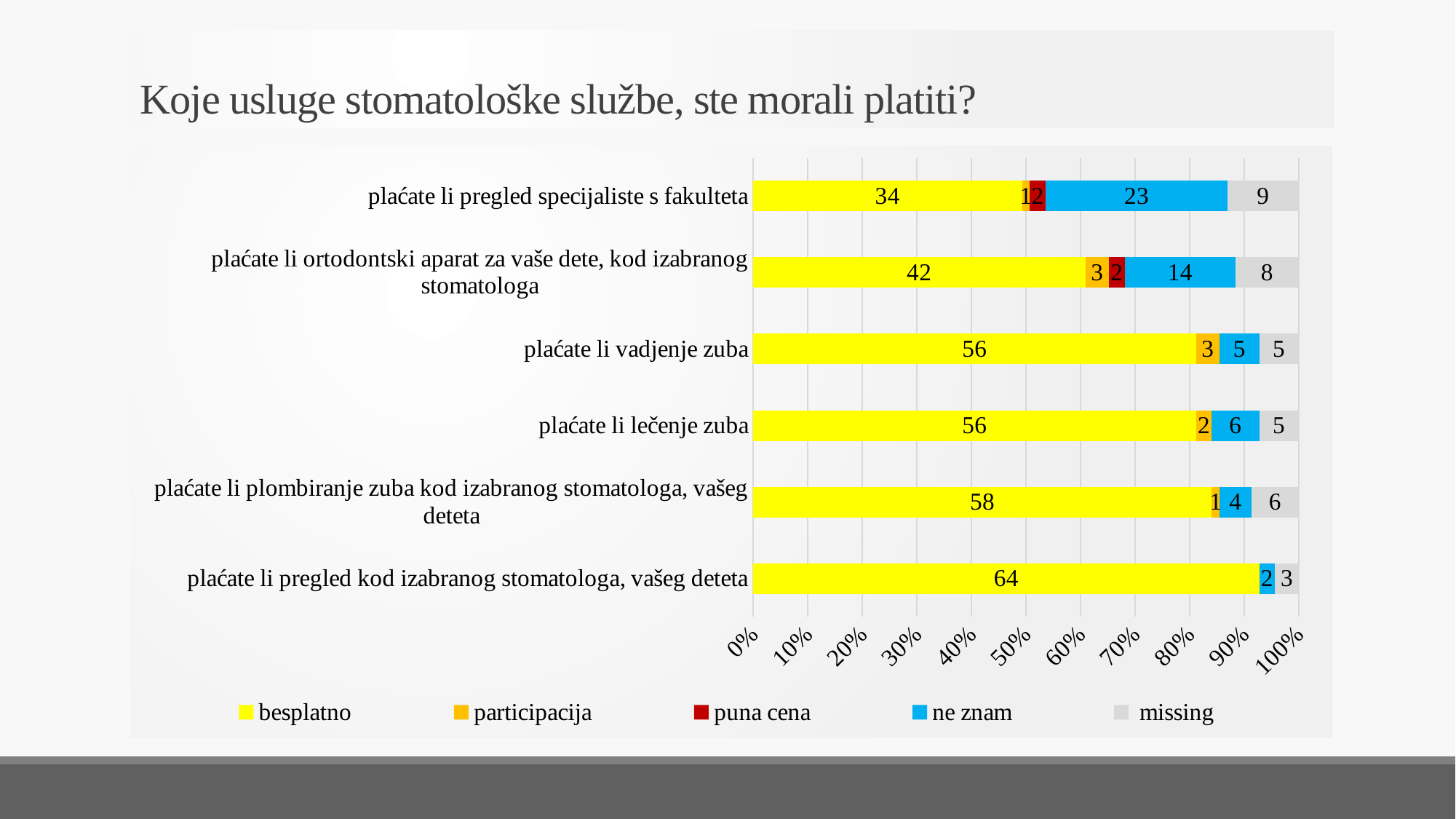
Which category has the highest 'besplatno' value? plaćate li pregled kod izabranog stomatologa, vašeg deteta How many series does the legend list? 5 What kind of chart is shown on the slide? Stacked bar chart What is the 'ne znam' value for 'plaćate li pregled specijaliste s fakulteta'? 23 What is the 'besplatno' value for 'plaćate li vadjenje zuba'? 56 How many categories (bars) are plotted in the chart? 6 Which category has the lowest 'besplatno' value? plaćate li pregled specijaliste s fakulteta What is the 'participacija' value for 'plaćate li lečenje zuba'? 2 What is the 'missing' value for 'plaćate li ortodontski aparat za vaše dete, kod izabranog stomatologa'? 8 What is the title of the chart slide? Koje usluge stomatološke službe, ste morali platiti? What is the difference between the 'besplatno' values for 'plaćate li plombiranje zuba kod izabranog stomatologa, vašeg deteta' and 'plaćate li ortodontski aparat za vaše dete, kod izabranog stomatologa'? 16 Which has the larger 'ne znam' value: 'plaćate li pregled specijaliste s fakulteta' or 'plaćate li ortodontski aparat za vaše dete, kod izabranog stomatologa'? plaćate li pregled specijaliste s fakulteta